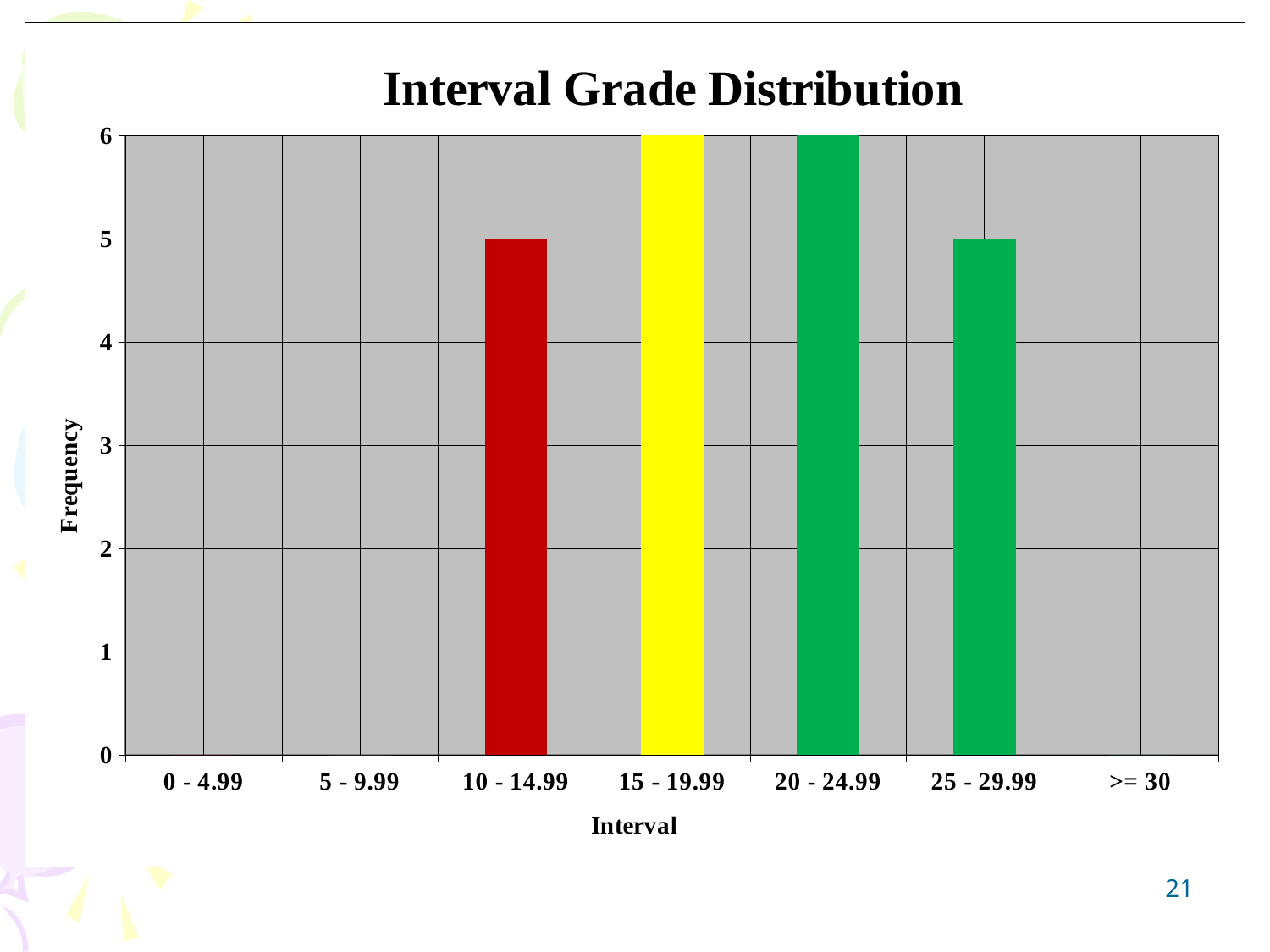
What kind of chart is shown on the slide? Bar chart How many interval categories are shown on the x axis? 7 What is the frequency for the 10 - 14.99 interval? 5 What is the difference in frequency between the 20 - 24.99 interval and the 25 - 29.99 interval? 1 What is the frequency for the 20 - 24.99 interval? 6 What is the frequency for the 15 - 19.99 interval? 6 What is the frequency for the 0 - 4.99 interval? 0 Is the frequency for the 25 - 29.99 interval greater or less than 3? greater What is the label of the vertical axis? Frequency What is the title of the chart? Interval Grade Distribution Which has the higher frequency, the 10 - 14.99 interval or the 15 - 19.99 interval? 15 - 19.99 What is the frequency for the 25 - 29.99 interval? 5